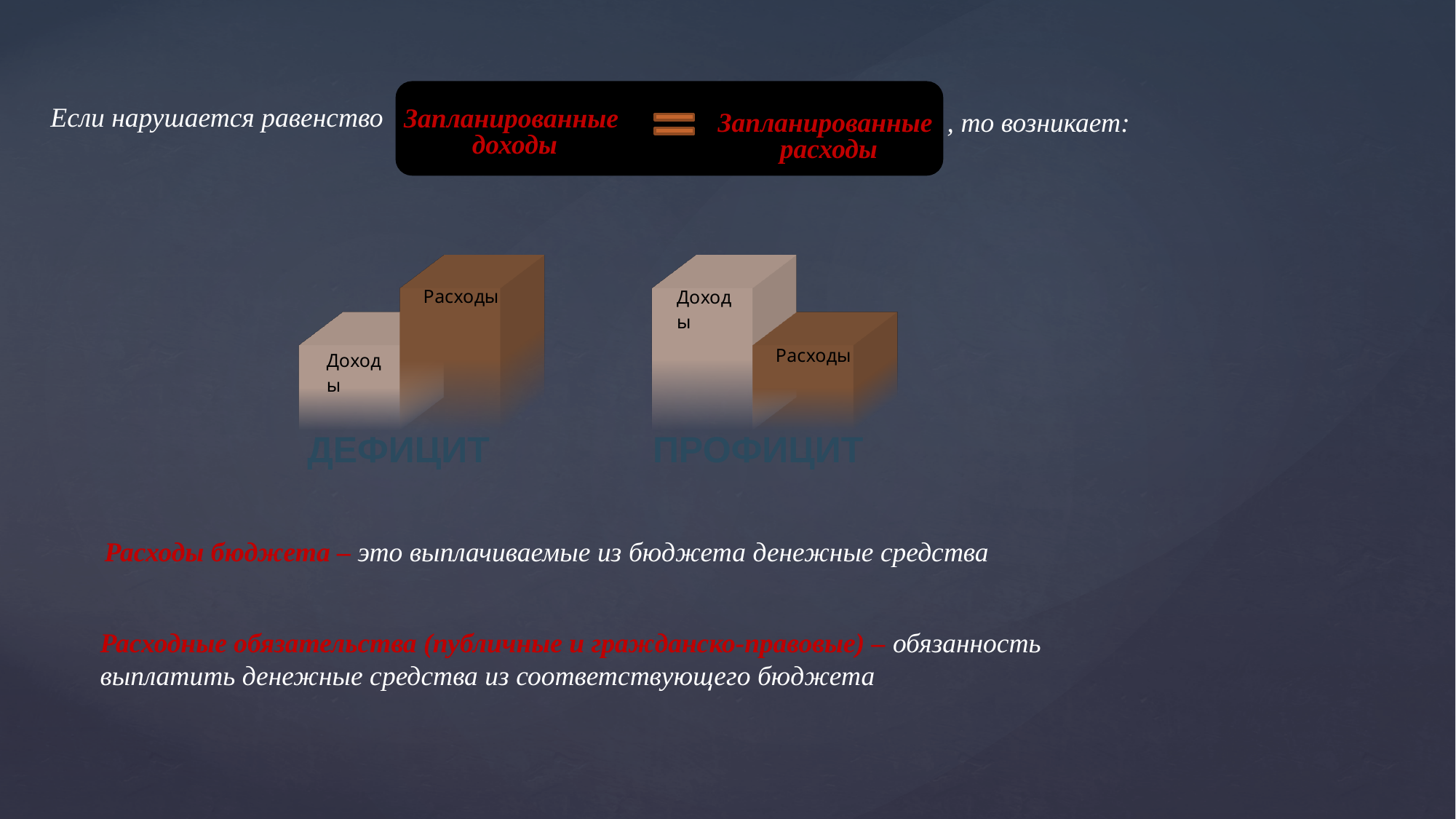
How many bars are shown in the ДЕФИЦИТ chart? 2 In the ПРОФИЦИТ chart, which bar is taller, Доходы or Расходы? Доходы What is the label under the right chart? ПРОФИЦИТ In the ПРОФИЦИТ chart, which bar is the lowest? Расходы How many charts are shown on the slide? 1 How many bars are shown in the ПРОФИЦИТ chart? 2 In the ДЕФИЦИТ chart, which bar is the lowest? Доходы What kind of chart is the ДЕФИЦИТ chart? Bar chart In the ПРОФИЦИТ chart, which bar is the highest? Доходы In the ДЕФИЦИТ chart, which bar is taller, Доходы or Расходы? Расходы What is the label under the left chart? ДЕФИЦИТ In the ДЕФИЦИТ chart, which bar is the highest? Расходы